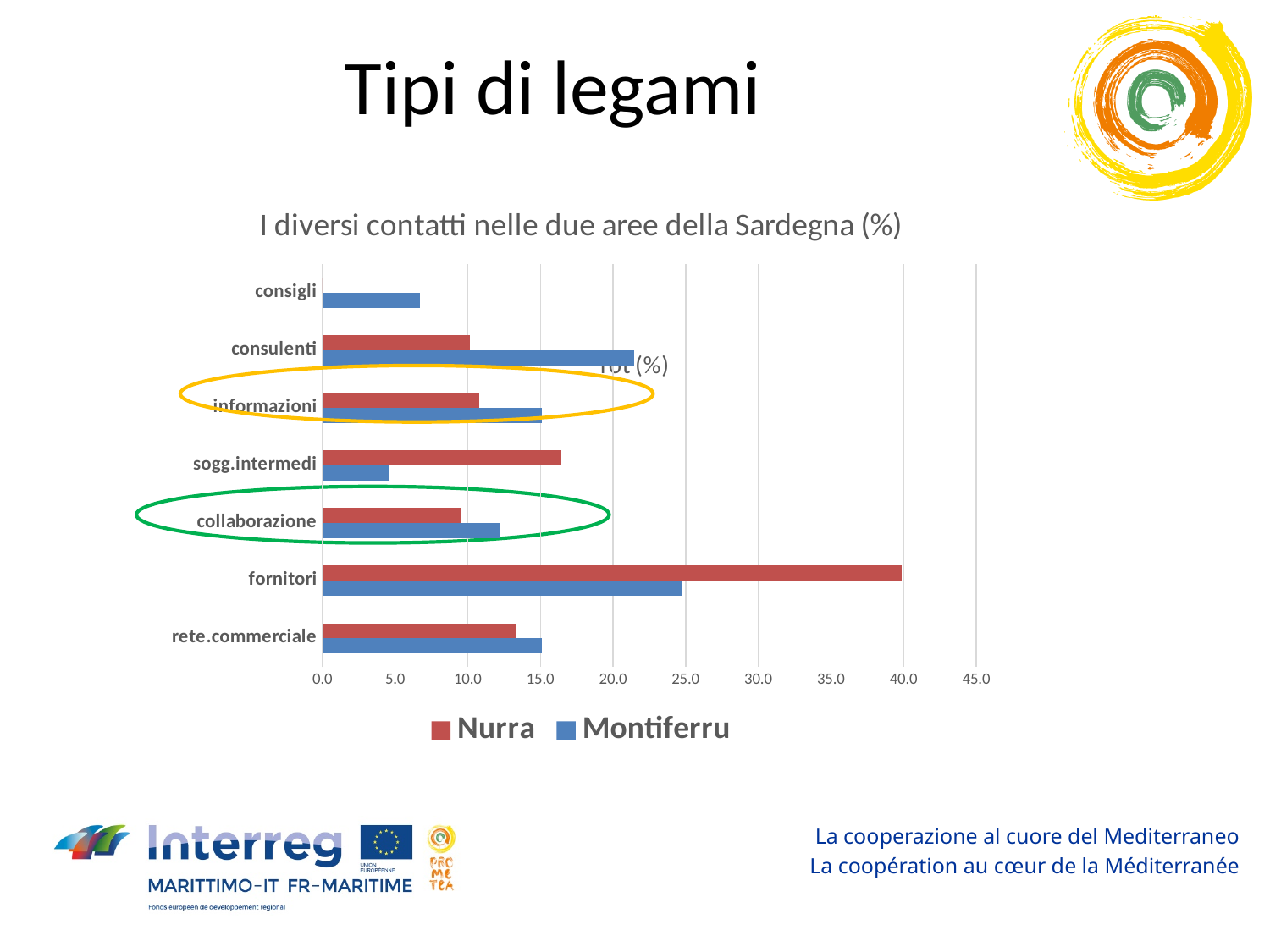
What kind of chart is shown on the slide? bar chart For consulenti, which series has the larger value, Nurra or Montiferru? Montiferru How many series does the chart's legend list? 2 Which category has the highest value for the Montiferru series? fornitori For sogg.intermedi, which series has the larger value, Nurra or Montiferru? Nurra Which category has the highest value for the Nurra series? fornitori Is the Montiferru value for consigli greater or less than 10.0? less What is the title of the chart? I diversi contatti nelle due aree della Sardegna (%) For fornitori, which series has the larger value, Nurra or Montiferru? Nurra Is the Nurra value for fornitori greater or less than 35.0? greater Which category has the lowest value for the Montiferru series? sogg.intermedi How many categories are shown on the chart's vertical axis? 7